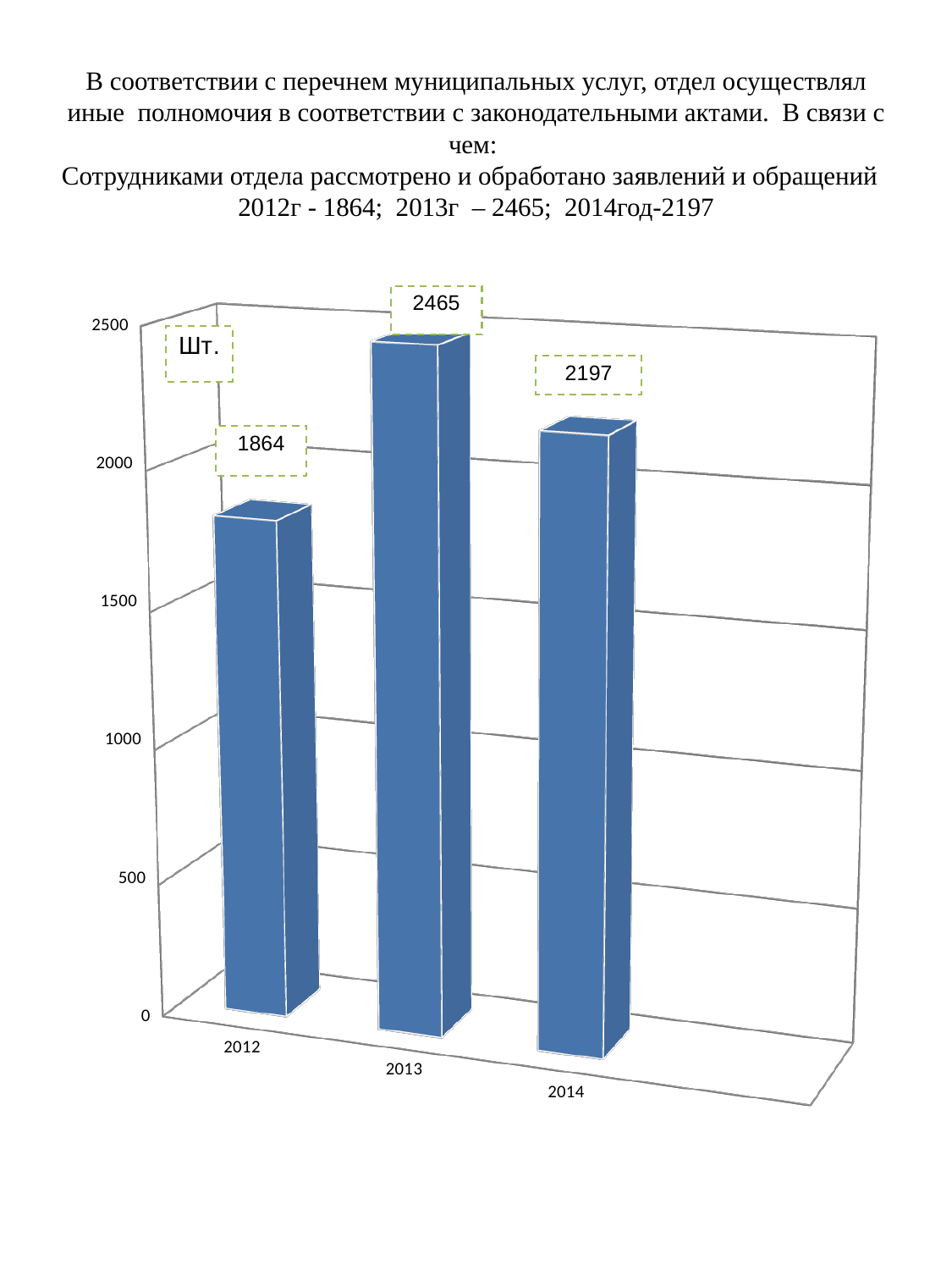
What is the difference between the values for 2013 and 2014? 268 Which year has the lowest value? 2012 Which is larger, the value for 2014 or the value for 2012? 2014 What is the value for 2014? 2197 Which year has the highest value? 2013 What is the value for 2013? 2465 What is the value for 2012? 1864 What is the difference between the values for 2013 and 2012? 601 What unit label is shown in the box at the top left of the chart? Шт. What kind of chart is shown on the slide? bar chart Is the value for 2012 greater or less than 2000? less How many years are shown on the x axis? 3